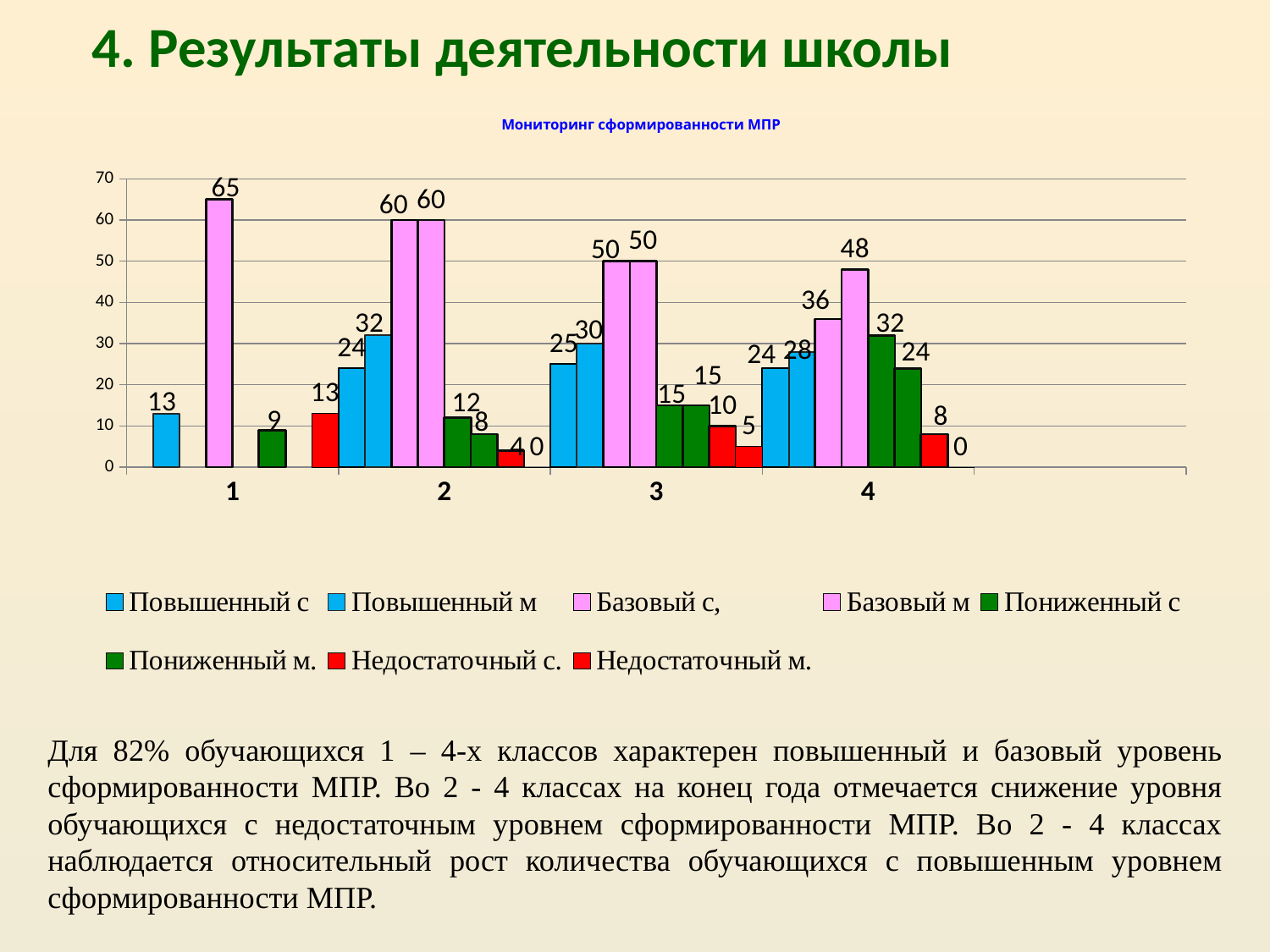
What is the value of Базовый м for class 4? 48 What is the difference between Базовый м and Базовый с for class 4? 12 What is the value of Повышенный м for class 3? 30 How many class categories are shown on the x axis? 4 What kind of chart is shown on the slide? bar chart Does the value of Базовый с rise or fall from class 1 to class 4? fall What is the title of the chart? Мониторинг сформированности МПР Which bar has the highest value in the whole chart? Базовый м for class 1 (65) Which series has the lowest value for class 3? Недостаточный м. (5) Which is larger: Базовый с for class 2 or Базовый с for class 3? Базовый с for class 2 (60) How many series does the legend list? 8